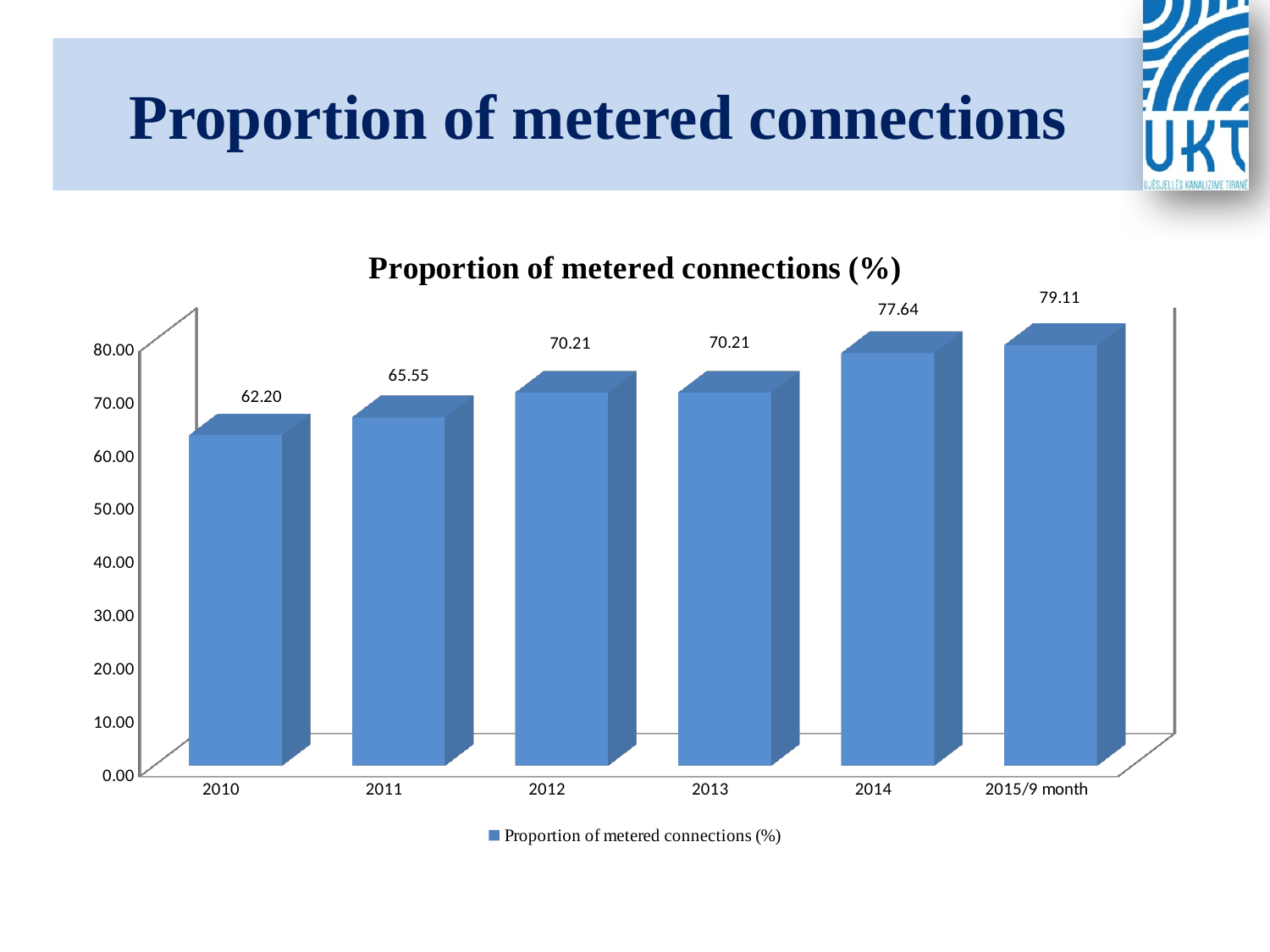
What is the difference between the values for 2011 and 2010? 3.35 Which category has the highest proportion of metered connections? 2015/9 month What value is shown for 2015/9 month? 79.11 Which year has the lowest proportion of metered connections? 2010 How many categories are shown on the x axis? 6 What is the proportion of metered connections in 2010? 62.20 What is the difference between the values for 2014 and 2013? 7.43 Do the values generally rise or fall from 2010 to 2015/9 month? Rise What kind of chart is shown on the slide? Bar chart What is the proportion of metered connections in 2014? 77.64 Which is larger, the value for 2012 or the value for 2011? 2012 How many series does the legend list? 1